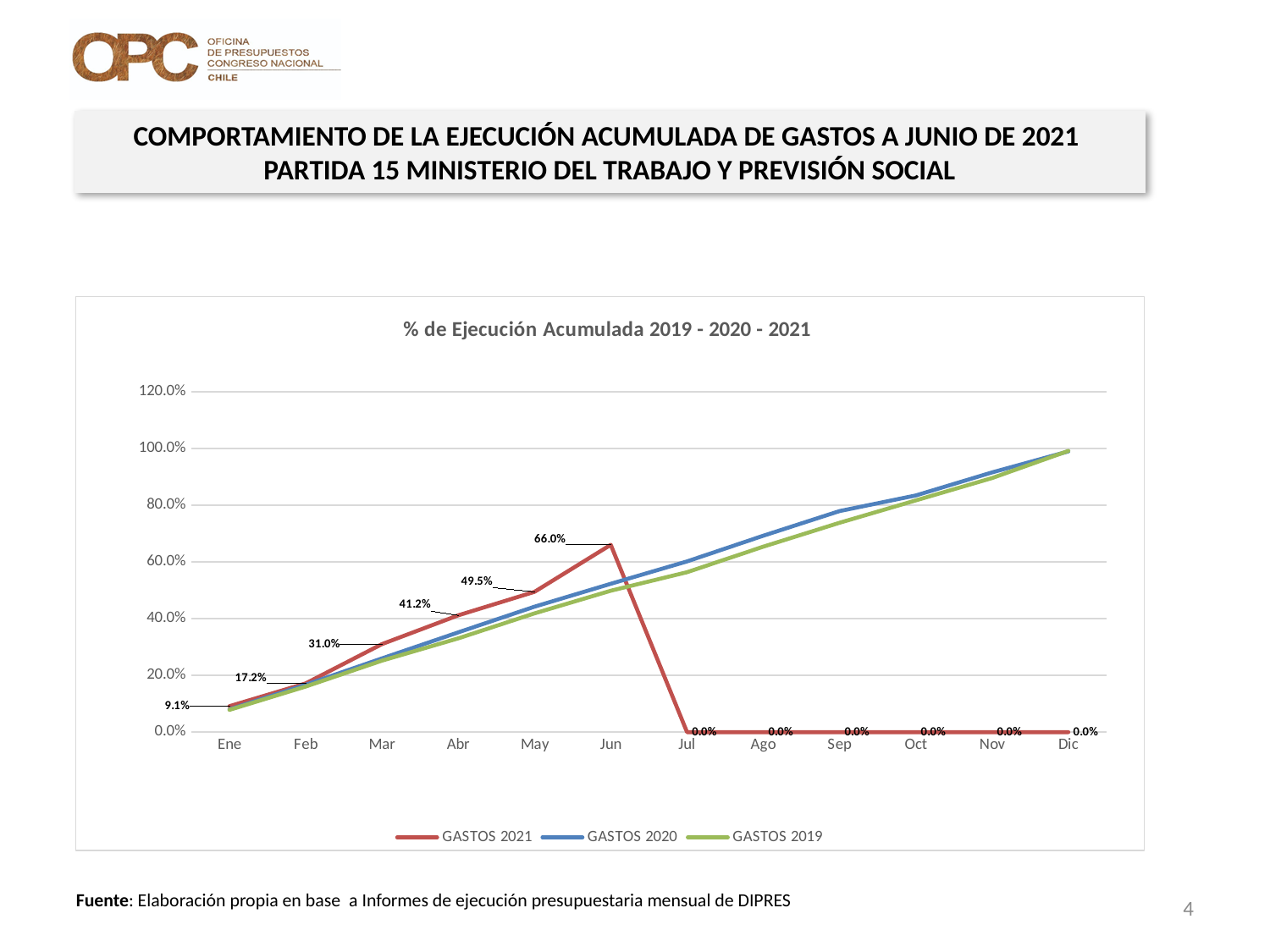
What is the difference between the GASTOS 2021 values for Mar and Feb? 13.8% What is the value of GASTOS 2021 in Jun? 66.0% Is the value for GASTOS 2020 in Mar greater or less than 40.0%? less What is the value of GASTOS 2021 in Ene? 9.1% In which month does GASTOS 2021 reach its highest value? Jun What kind of chart is shown on the slide? line chart By how much did GASTOS 2021 increase from May to Jun? 16.5% What is the value of GASTOS 2021 in Abr? 41.2% How many months are shown on the x axis of the chart? 12 How many series does the legend of the chart list? 3 In Jun, which series has the higher value, GASTOS 2021 or GASTOS 2020? GASTOS 2021 What is the title of the chart? % de Ejecución Acumulada 2019 - 2020 - 2021